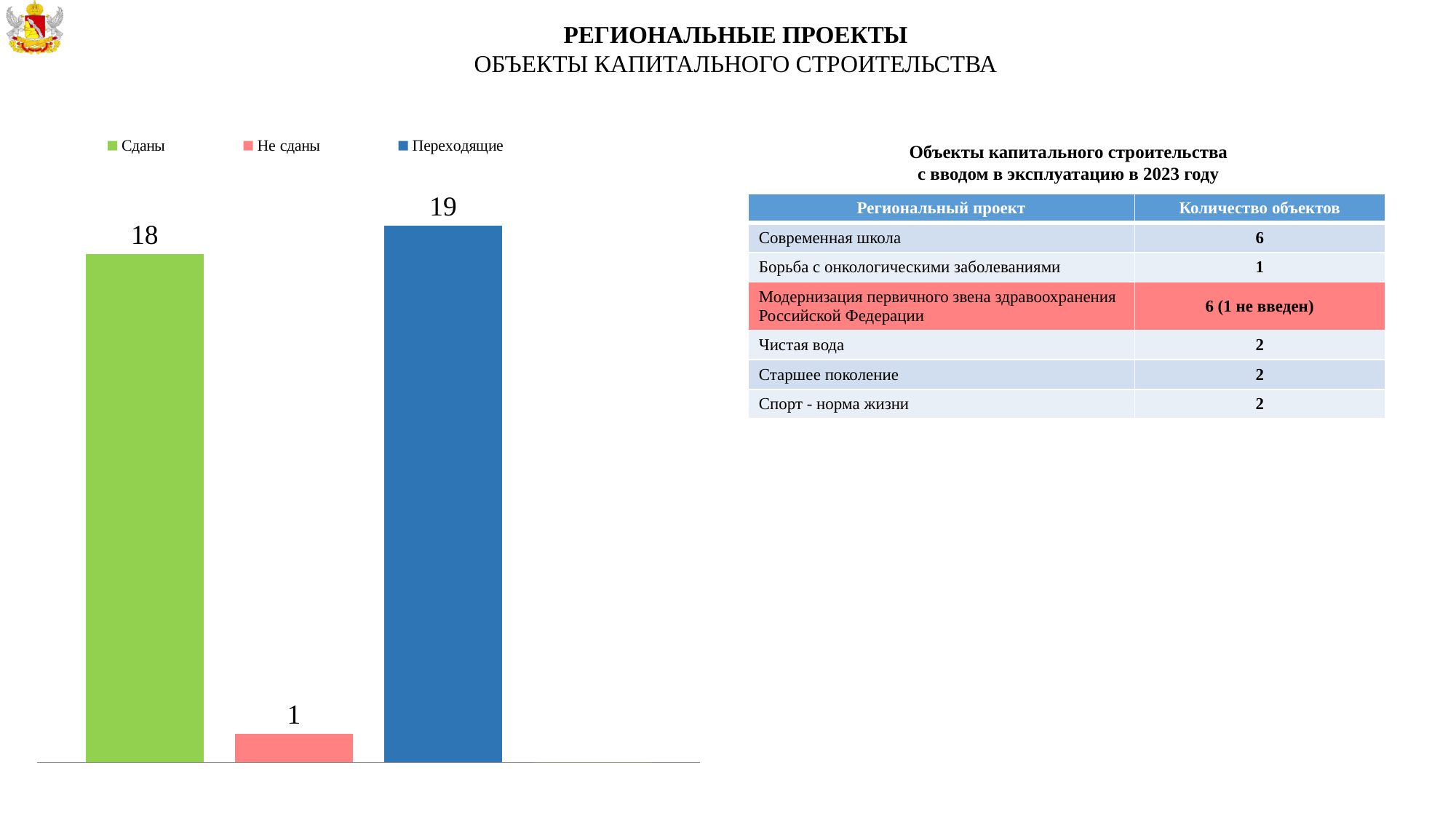
Which series has the lowest value? Не сданы What is the value for Переходящие? 19 Which is larger, the value for Сданы or the value for Не сданы? Сданы What is the difference between the values for Сданы and Не сданы? 17 How many bars are plotted in the chart? 3 What kind of chart is shown on the slide? Bar chart Which series has the highest value? Переходящие How many series does the legend list? 3 What is the value for Не сданы? 1 What is the value for Сданы? 18 What is the difference between the values for Переходящие and Сданы? 1 What colour is the bar for Переходящие? Blue